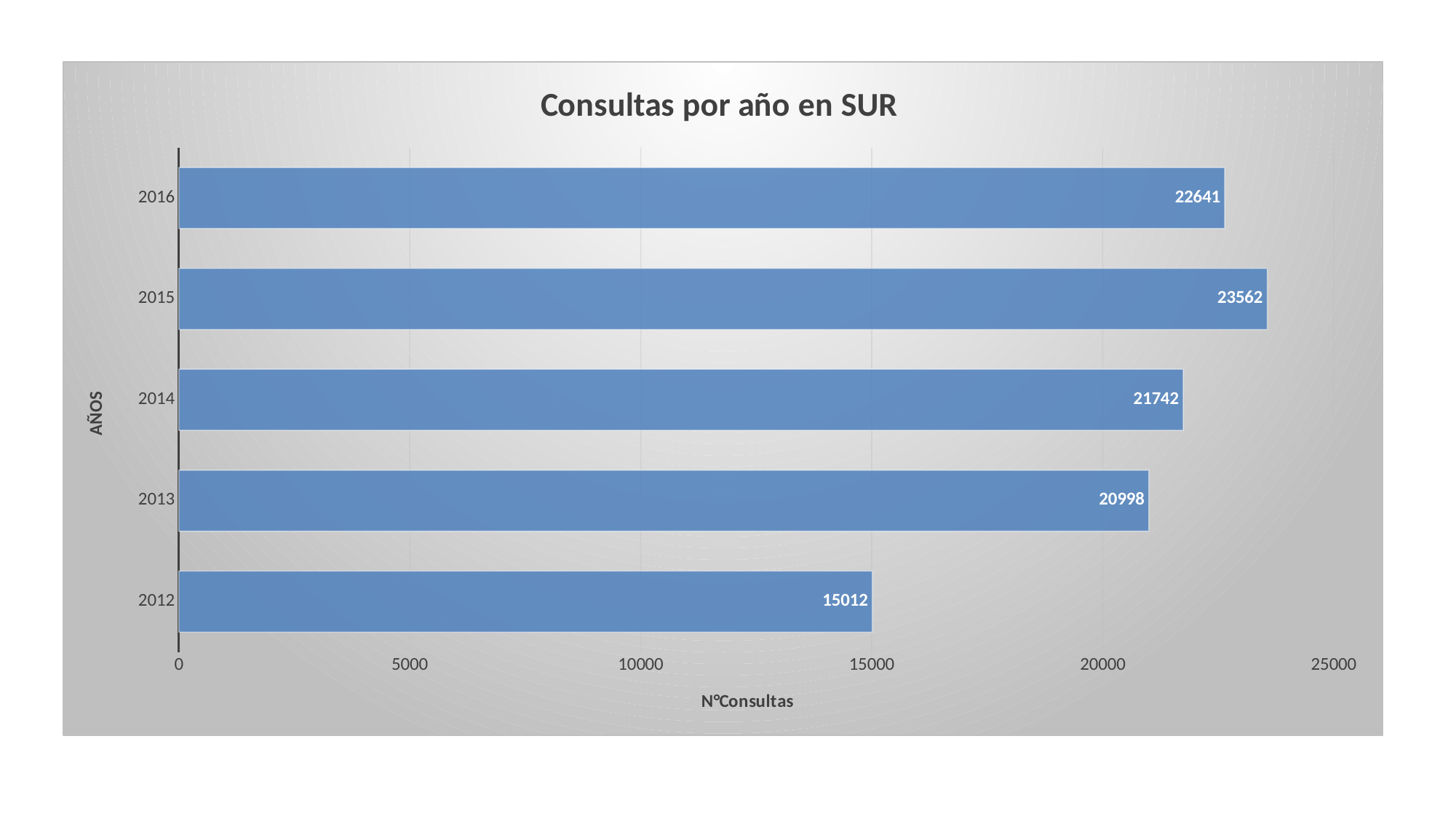
What is the number of consultas for 2012? 15012 Which year has more consultas, 2013 or 2014? 2014 What is the title of the chart? Consultas por año en SUR Which year has the lowest number of consultas? 2012 Which year has the highest number of consultas? 2015 Is the value for 2013 greater or less than 20000? greater What is the number of consultas for 2016? 22641 What is the difference between the consultas in 2015 and 2016? 921 What is the number of consultas for 2014? 21742 What kind of chart is this? bar chart How many years are shown in the chart? 5 What is the difference between the consultas in 2013 and 2012? 5986